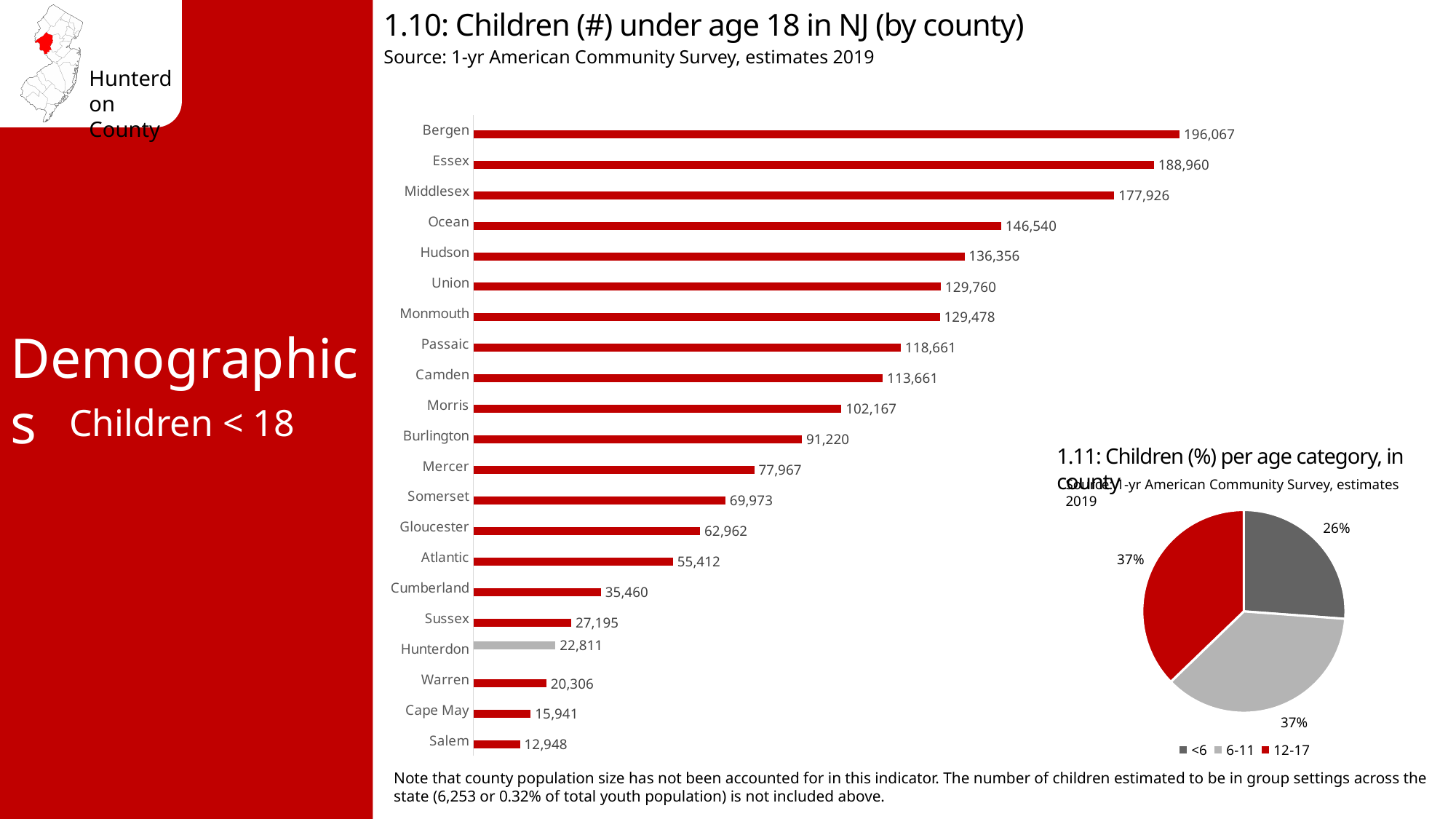
In chart 1.10, which county has more children under 18, Passaic or Camden? Passaic In chart 1.10, what is the difference between the values for Bergen and Essex? 7,107 In chart 1.10, how many children under age 18 are in Ocean County? 146,540 In chart 1.11, what share of children are under age 6? 26% In chart 1.10, which county has the lowest number of children under age 18? Salem In chart 1.10, how many children under age 18 are in Hunterdon County? 22,811 In chart 1.10, how many counties are shown? 21 What kind of chart is chart 1.10? Bar chart In chart 1.11, how many age categories does the legend list? 3 In chart 1.10, which county's bar is coloured grey instead of red? Hunterdon In chart 1.10, what is the difference between the values for Hunterdon and Warren? 2,505 In chart 1.10, which county has the highest number of children under age 18? Bergen